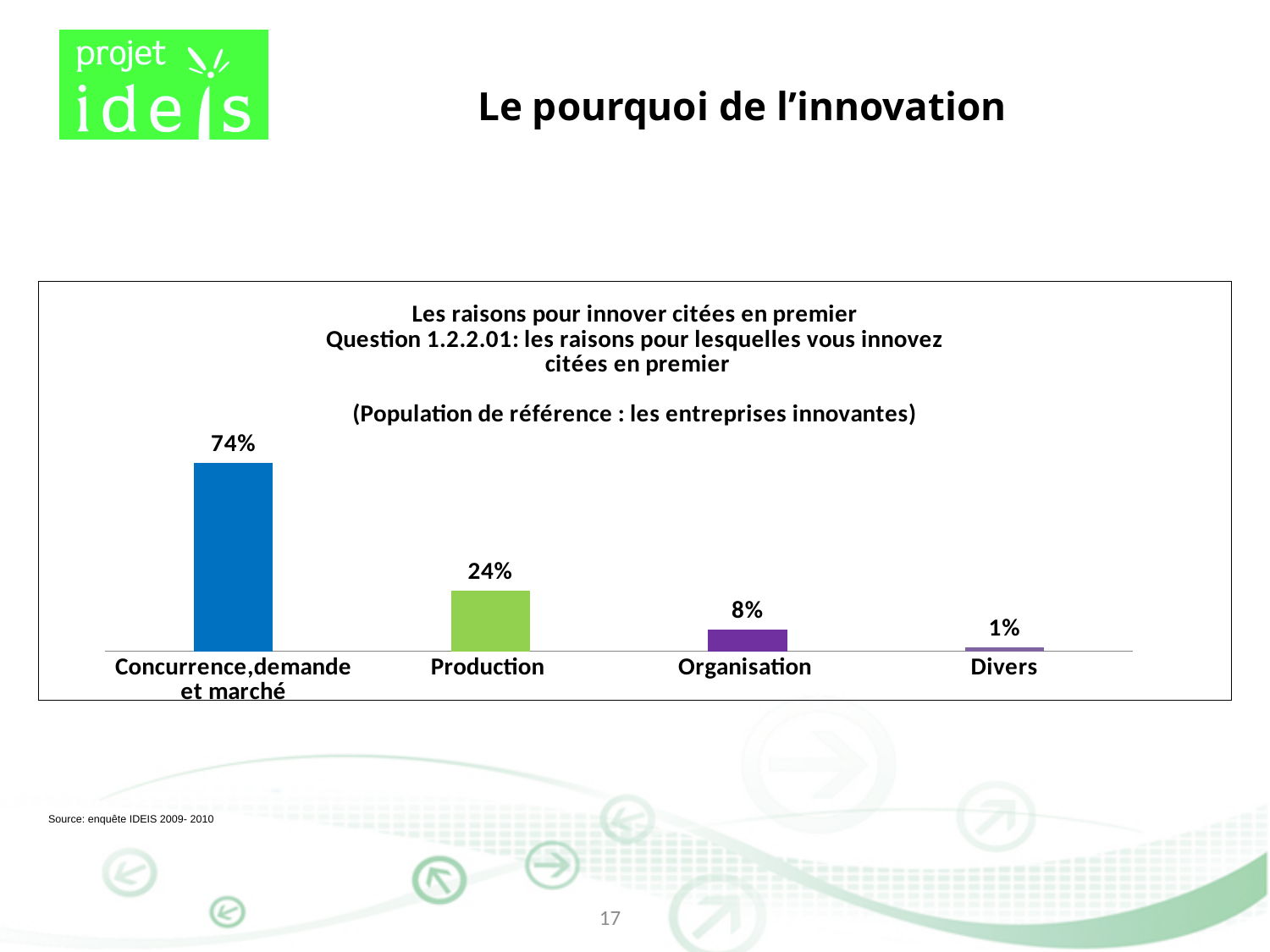
What is the value for Production? 24% Which is larger, the value for Organisation or the value for Divers? Organisation Do the values rise or fall from left to right across the categories? Fall Which category has the highest value? Concurrence, demande et marché What is the value for Divers? 1% How many categories are shown in the chart? 4 What is the difference between the values for Concurrence, demande et marché and Production? 50% What is the difference between the values for Production and Organisation? 16% What is the value for Organisation? 8% What is the value for Concurrence, demande et marché? 74% Which category has the lowest value? Divers What kind of chart is shown on the slide? Bar chart